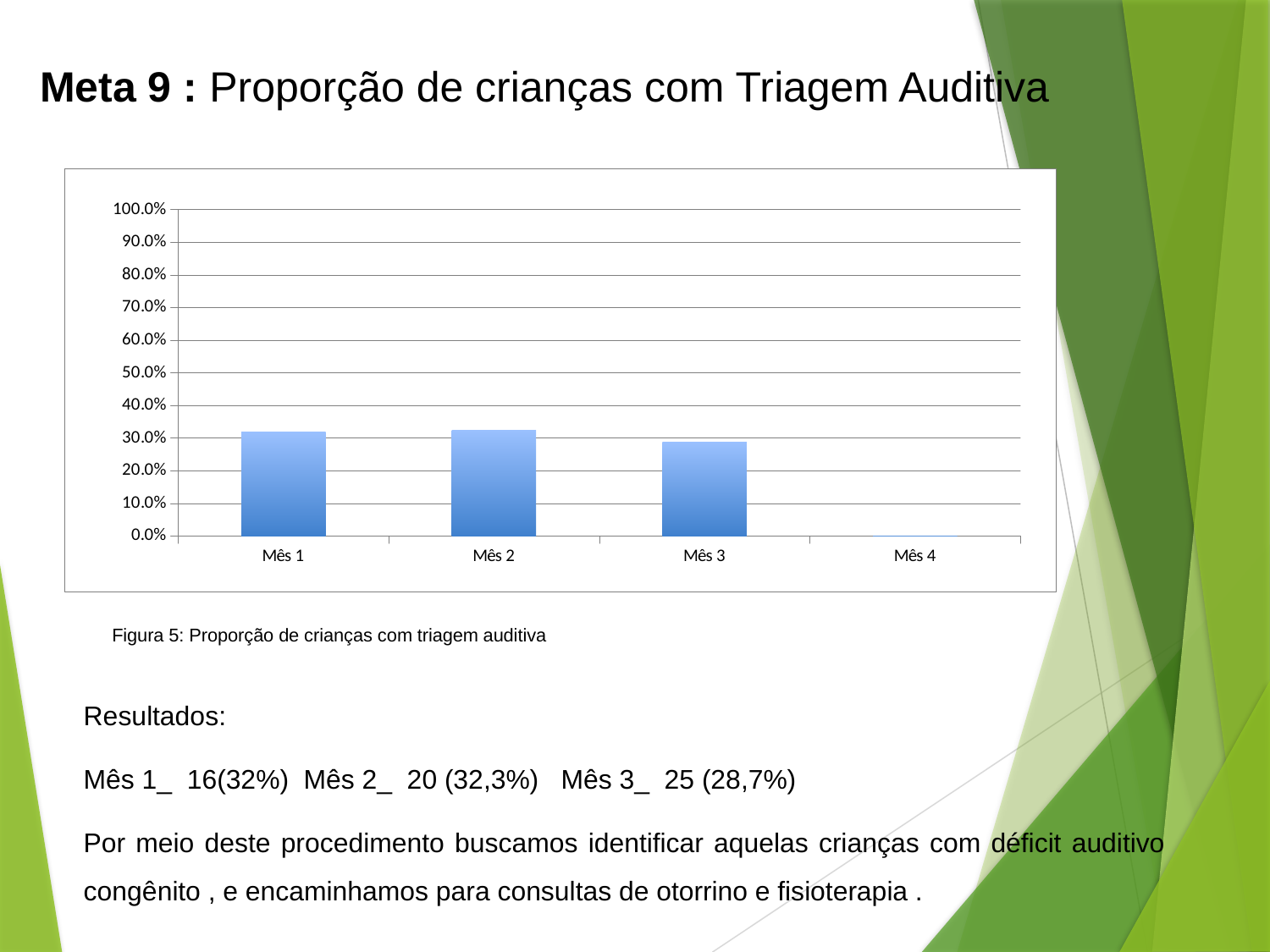
How many categories are shown on the x axis of the chart? 4 Is the value for Mês 3 greater or less than 30.0%? less Is the value for Mês 1 greater or less than 40.0%? less What is the highest value shown on the y axis of the chart? 100.0% Which category on the x axis has no bar plotted? Mês 4 Is the value for Mês 3 greater or less than 20.0%? greater Which of Mês 2 and Mês 3 has the larger value? Mês 2 What kind of chart is shown on the slide? bar chart Does the value rise or fall from Mês 2 to Mês 3? fall Which of Mês 1 and Mês 3 has the larger value? Mês 1